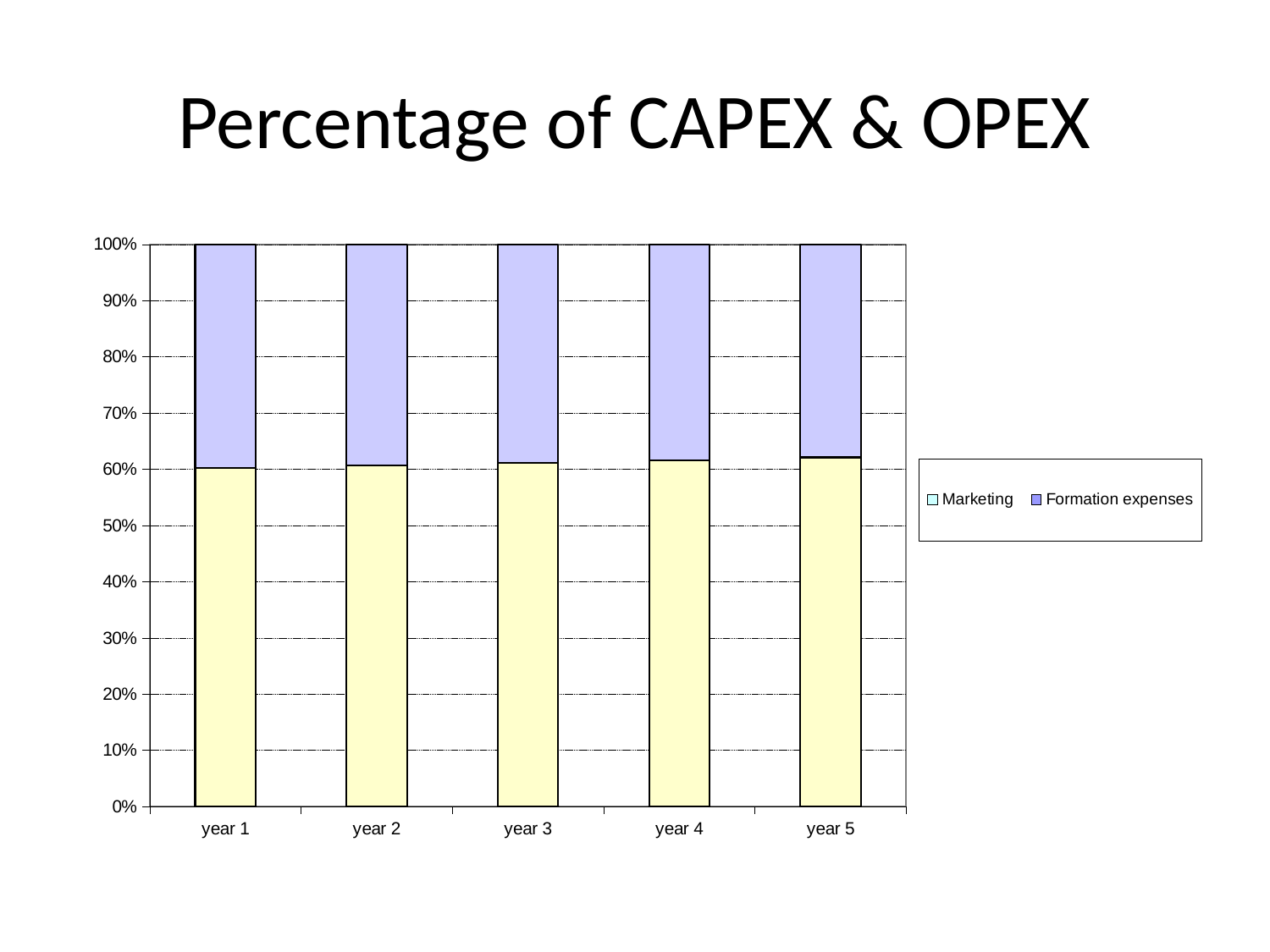
What is the title of the chart? Percentage of CAPEX & OPEX Which two series are listed in the legend? Marketing and Formation expenses Is the value for Formation expenses in year 3 greater or less than 30%? greater How many categories are shown on the x axis? 5 In year 3, which is larger: Marketing or Formation expenses? Marketing What kind of chart is shown on the slide? stacked bar chart Is the value for Marketing in year 1 greater or less than 50%? greater Is the value for Marketing in year 5 greater or less than 70%? less How many series does the legend list? 2 In year 5, which is larger: Formation expenses or Marketing? Marketing Does the Marketing share rise or fall from year 1 to year 5? rise